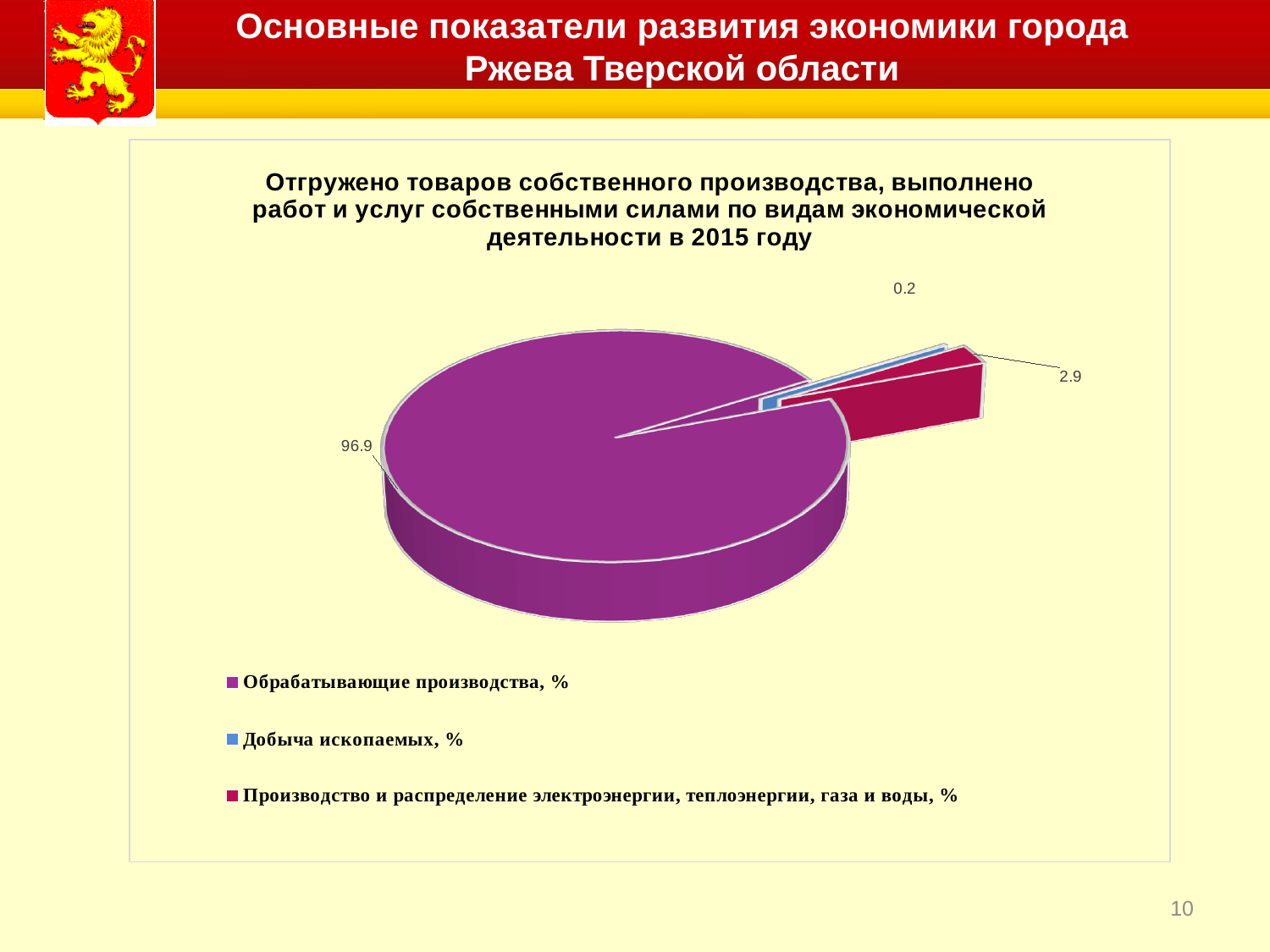
What type of chart is shown on the slide? pie chart Which is larger: the value for Добыча ископаемых or the value for Производство и распределение электроэнергии, теплоэнергии, газа и воды? Производство и распределение электроэнергии, теплоэнергии, газа и воды What is the difference between the values for Обрабатывающие производства and Производство и распределение электроэнергии, теплоэнергии, газа и воды? 94.0 What share of the pie does Обрабатывающие производства take? 96.9% What is the value for Добыча ископаемых, %? 0.2 How many categories does the pie chart show? 3 What is the value for Обрабатывающие производства, %? 96.9 What colour is the slice for Добыча ископаемых, %? blue What is the difference between the values for Производство и распределение электроэнергии, теплоэнергии, газа и воды and Добыча ископаемых? 2.7 What is the value for Производство и распределение электроэнергии, теплоэнергии, газа и воды, %? 2.9 Which category has the largest slice of the pie? Обрабатывающие производства, % Which category has the smallest slice of the pie? Добыча ископаемых, %